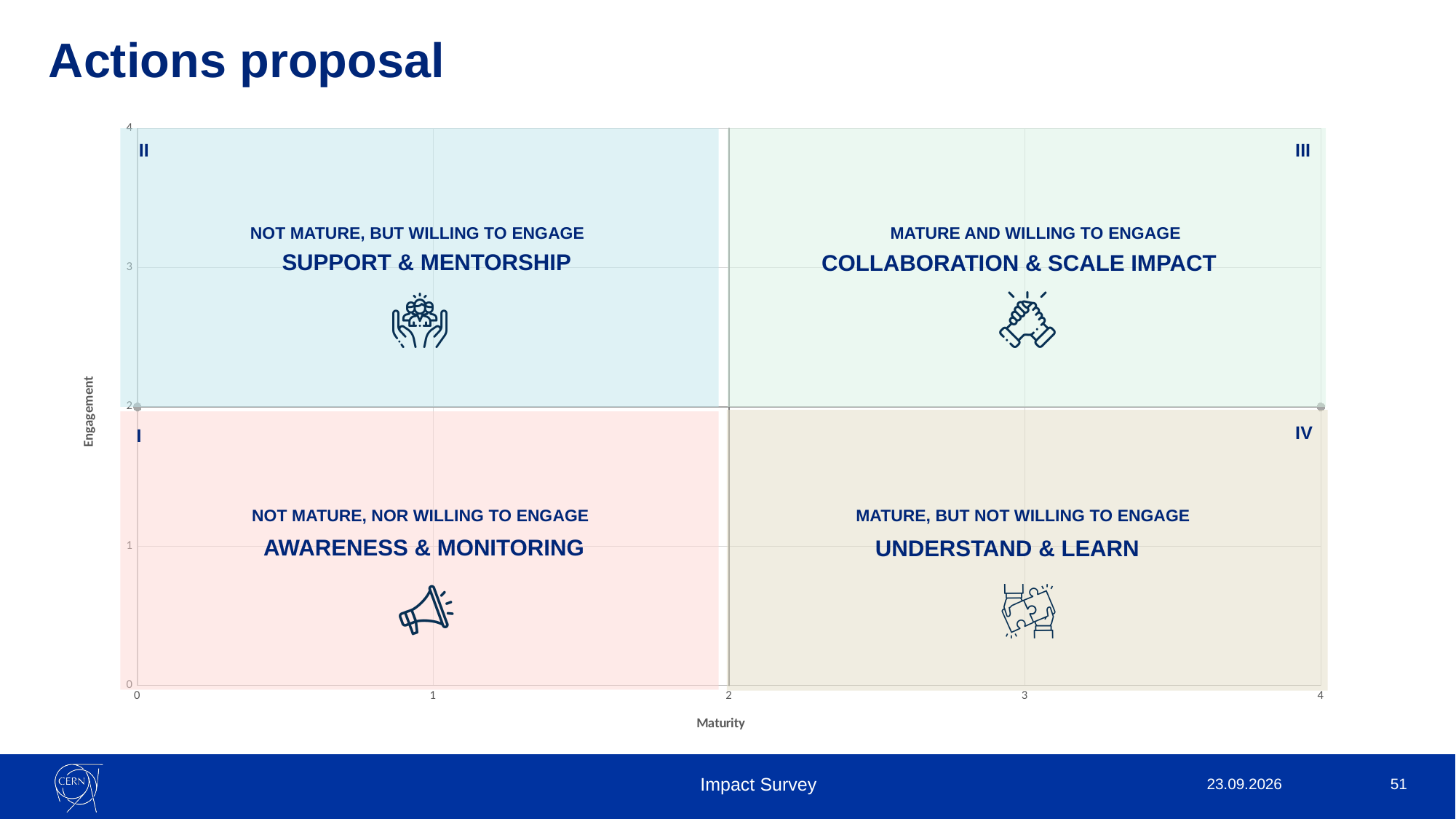
Which quadrant of the chart proposes 'SUPPORT & MENTORSHIP'? II What is the highest tick value shown on the Maturity axis? 4 What action is proposed in quadrant III of the chart? COLLABORATION & SCALE IMPACT What is the label of the vertical axis of the chart? Engagement What kind of chart is shown on the slide? A quadrant (2x2 matrix) chart What is the lowest tick value shown on the Engagement axis? 0 At what Maturity value is the vertical dividing line between the left and right quadrants drawn? 2 At what Engagement value is the horizontal dividing line between the upper and lower quadrants drawn? 2 What is the label of the horizontal axis of the chart? Maturity Which quadrant of the chart is labelled 'MATURE, BUT NOT WILLING TO ENGAGE'? IV What action is proposed in quadrant I of the chart? AWARENESS & MONITORING How many quadrants does the chart divide the plot area into? 4